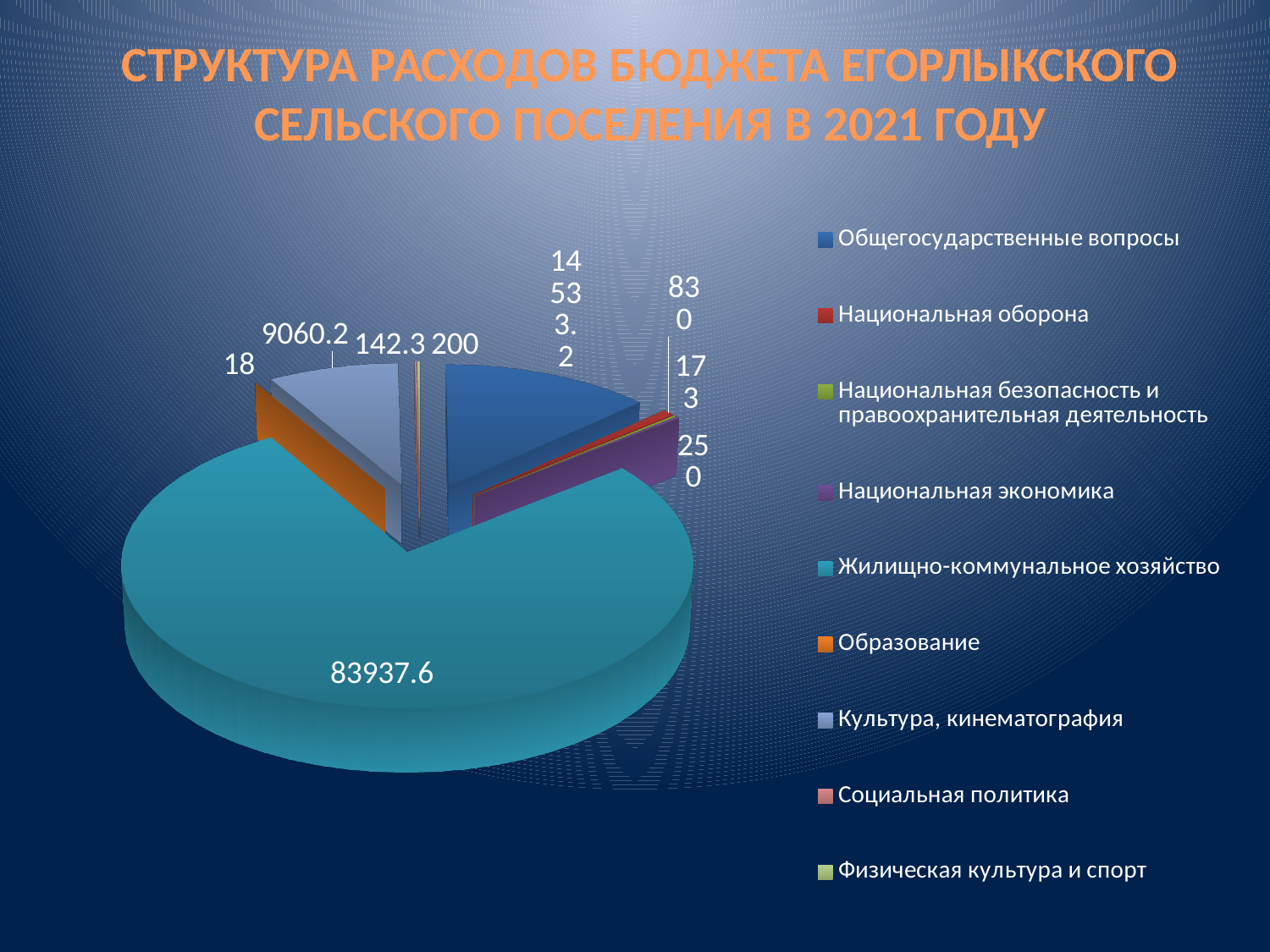
What is the title of the chart on the slide? СТРУКТУРА РАСХОДОВ БЮДЖЕТА ЕГОРЛЫКСКОГО СЕЛЬСКОГО ПОСЕЛЕНИЯ В 2021 ГОДУ What is the difference between the value for Жилищно-коммунальное хозяйство (83937.6) and the value for Общегосударственные вопросы (14533.2)? 69404.4 What is the value shown for the largest slice of the pie chart? 83937.6 What is the value shown for Культура, кинематография? 9060.2 How many categories does the legend of the pie chart list? 9 Which category has the largest slice in the pie chart? Жилищно-коммунальное хозяйство How many data labels are printed on the pie chart? 9 What is the value shown for Общегосударственные вопросы? 14533.2 What is the smallest value printed as a data label on the pie chart? 18 Which is larger: the value for Жилищно-коммунальное хозяйство or the value for Общегосударственные вопросы? Жилищно-коммунальное хозяйство What type of chart is shown on the slide? pie chart Which legend entry is listed first in the pie chart's legend? Общегосударственные вопросы